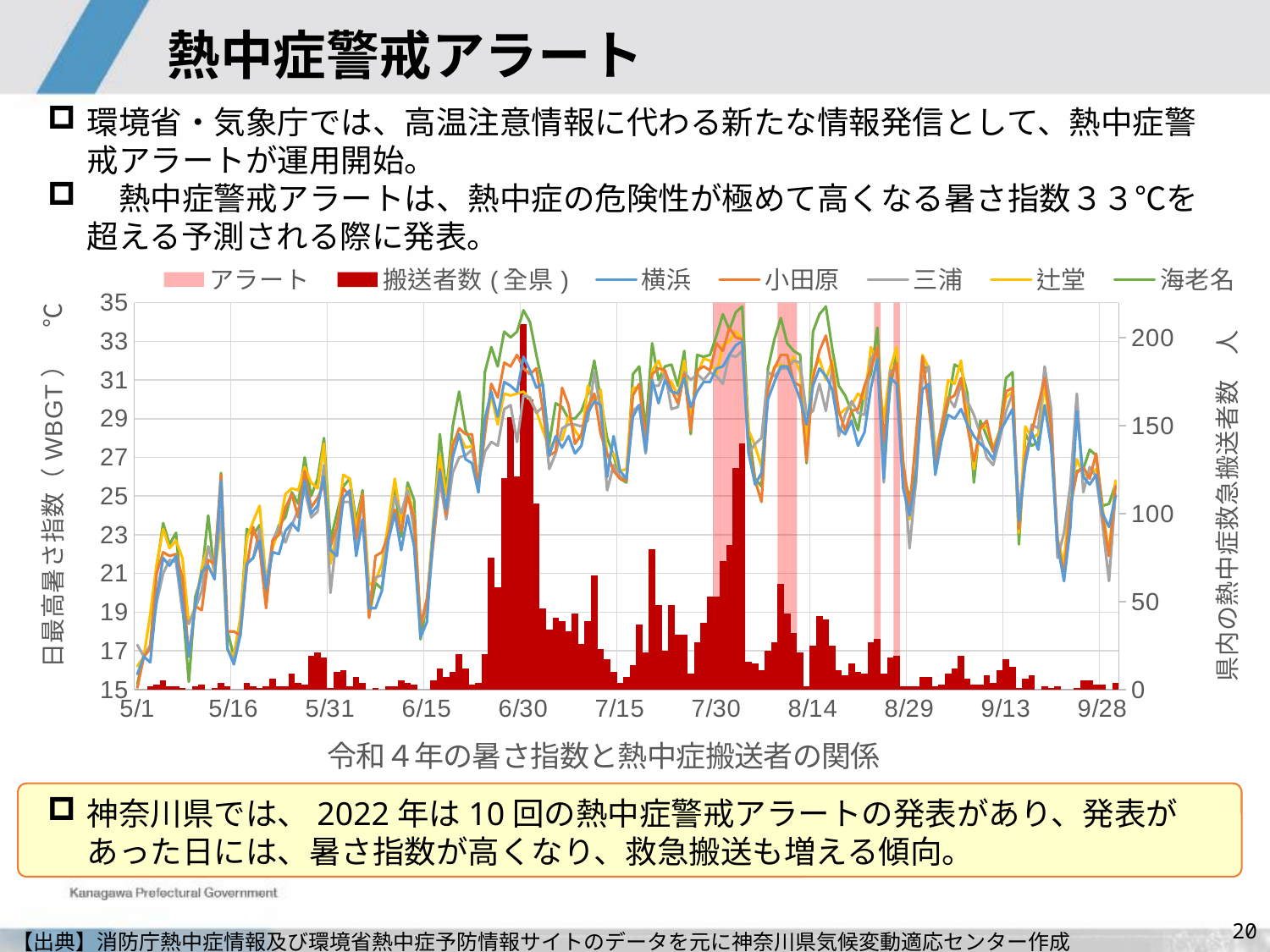
What kind of chart is shown on the slide? A combined bar and line chart Is the highest point reached by the 海老名 line greater or less than 33 on the left axis? greater Which legend entry is drawn as dark red bars? 搬送者数（全県） Is the tallest 搬送者数（全県） bar (around 6/30) greater or less than 150 on the right axis? greater What is the title shown below the chart? 令和４年の暑さ指数と熱中症搬送者の関係 How many entries does the chart legend list? 7 What is the last date label on the x axis? 9/28 What is the first date label on the x axis? 5/1 Do the WBGT lines generally rise or fall from 5/1 to 6/30? rise How many line series (cities) are plotted for the WBGT index? 5 What is the maximum value shown on the left (WBGT) axis? 35 How many date labels are shown on the x axis? 11